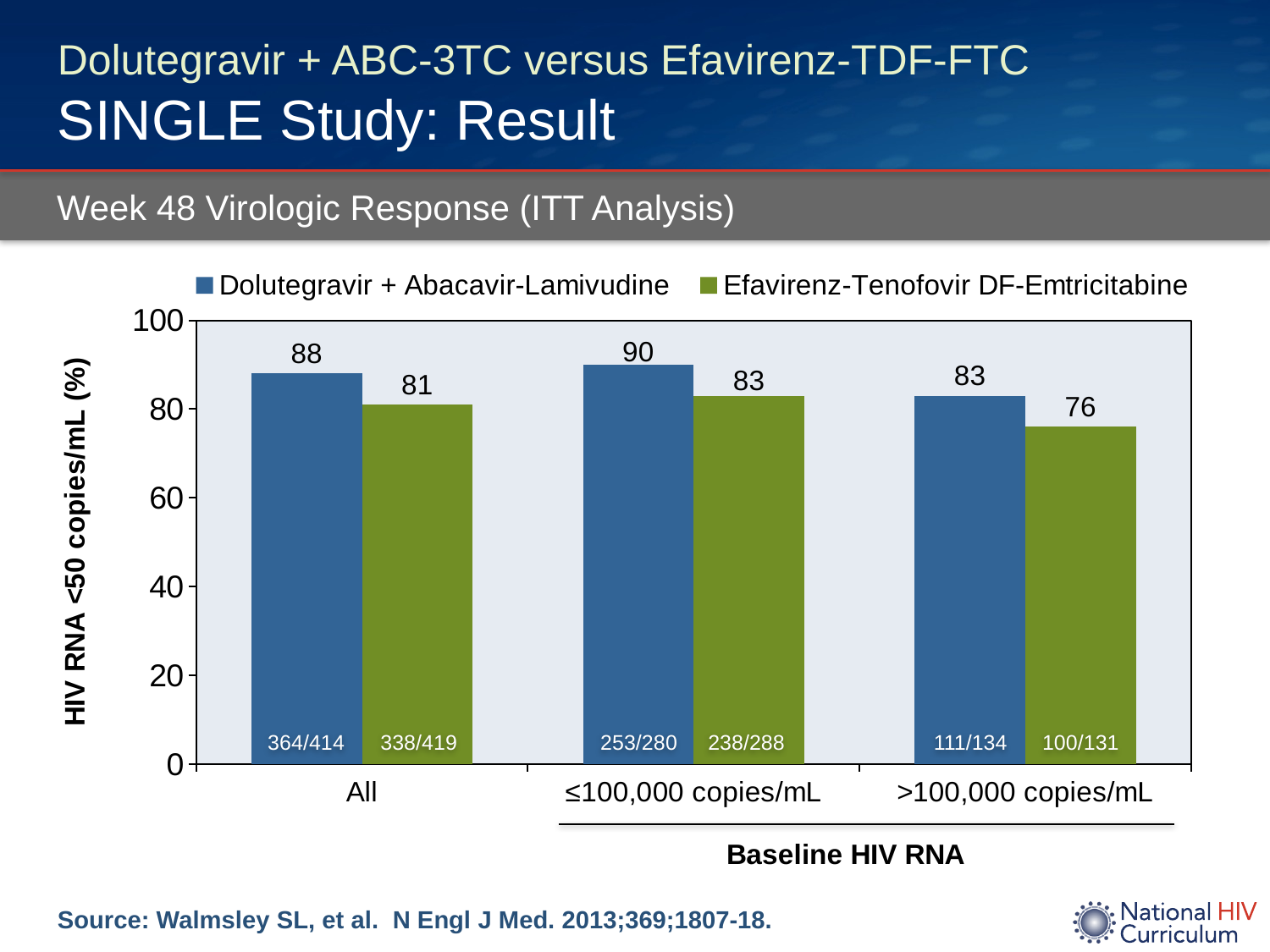
What is the value for Dolutegravir + Abacavir-Lamivudine in the All category? 88 What is the label of the y axis? HIV RNA <50 copies/mL (%) How many series does the legend list? 2 Which baseline HIV RNA category has the highest value for Dolutegravir + Abacavir-Lamivudine? ≤100,000 copies/mL In the >100,000 copies/mL category, which series has the larger value? Dolutegravir + Abacavir-Lamivudine What kind of chart is shown on the slide? Bar chart What is the value for Efavirenz-Tenofovir DF-Emtricitabine in the ≤100,000 copies/mL category? 83 Which baseline HIV RNA category has the lowest value for Efavirenz-Tenofovir DF-Emtricitabine? >100,000 copies/mL How many baseline HIV RNA categories are shown on the x axis? 3 What is the value for Efavirenz-Tenofovir DF-Emtricitabine in the >100,000 copies/mL category? 76 What is the difference between the Dolutegravir + Abacavir-Lamivudine and Efavirenz-Tenofovir DF-Emtricitabine values in the All category? 7 Is the value for Efavirenz-Tenofovir DF-Emtricitabine in the >100,000 copies/mL category greater or less than 80? less